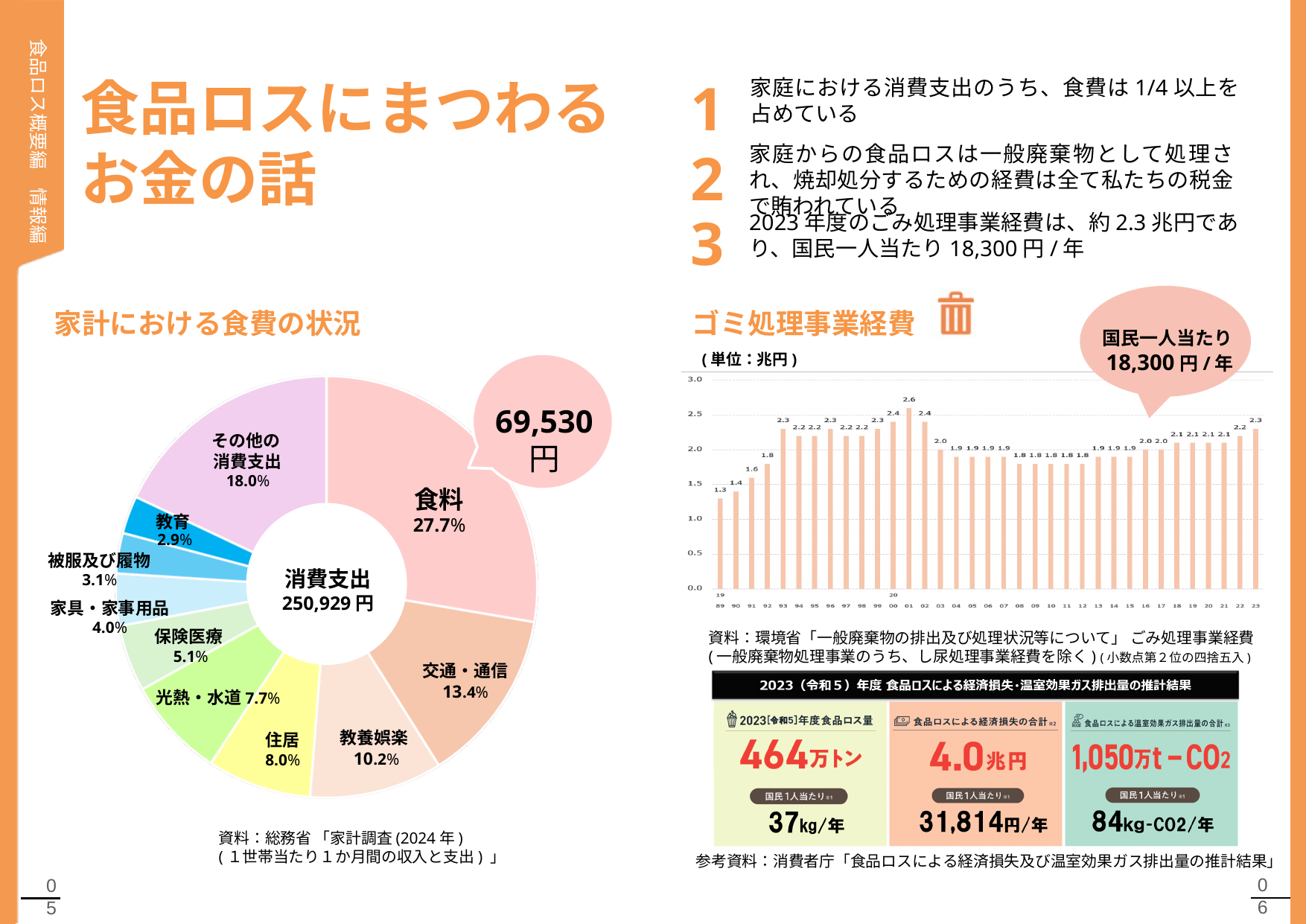
In the pie chart 家計における食費の状況, what percentage share does 食料 have? 27.7% In the pie chart 家計における食費の状況, how many categories are shown? 10 What type of chart is ゴミ処理事業経費? Bar chart In the bar chart ゴミ処理事業経費, what is the difference between the values for 2001 (01) and 2023 (23)? 0.3 In the pie chart 家計における食費の状況, what is the total 消費支出 shown in the centre? 250,929 円 In the pie chart 家計における食費の状況, what is the difference in percentage points between 住居 and 光熱・水道? 0.3 In the bar chart ゴミ処理事業経費, what is the value for 2001 (01)? 2.6 In the pie chart 家計における食費の状況, which is larger, 教養娯楽 or 保険医療? 教養娯楽 In the pie chart 家計における食費の状況, which category has the largest share? 食料 In the pie chart 家計における食費の状況, which category has the smallest share? 教育 In the pie chart 家計における食費の状況, what is the share for 交通・通信? 13.4% In the bar chart ゴミ処理事業経費, which year has the lowest value? 1989 (89)